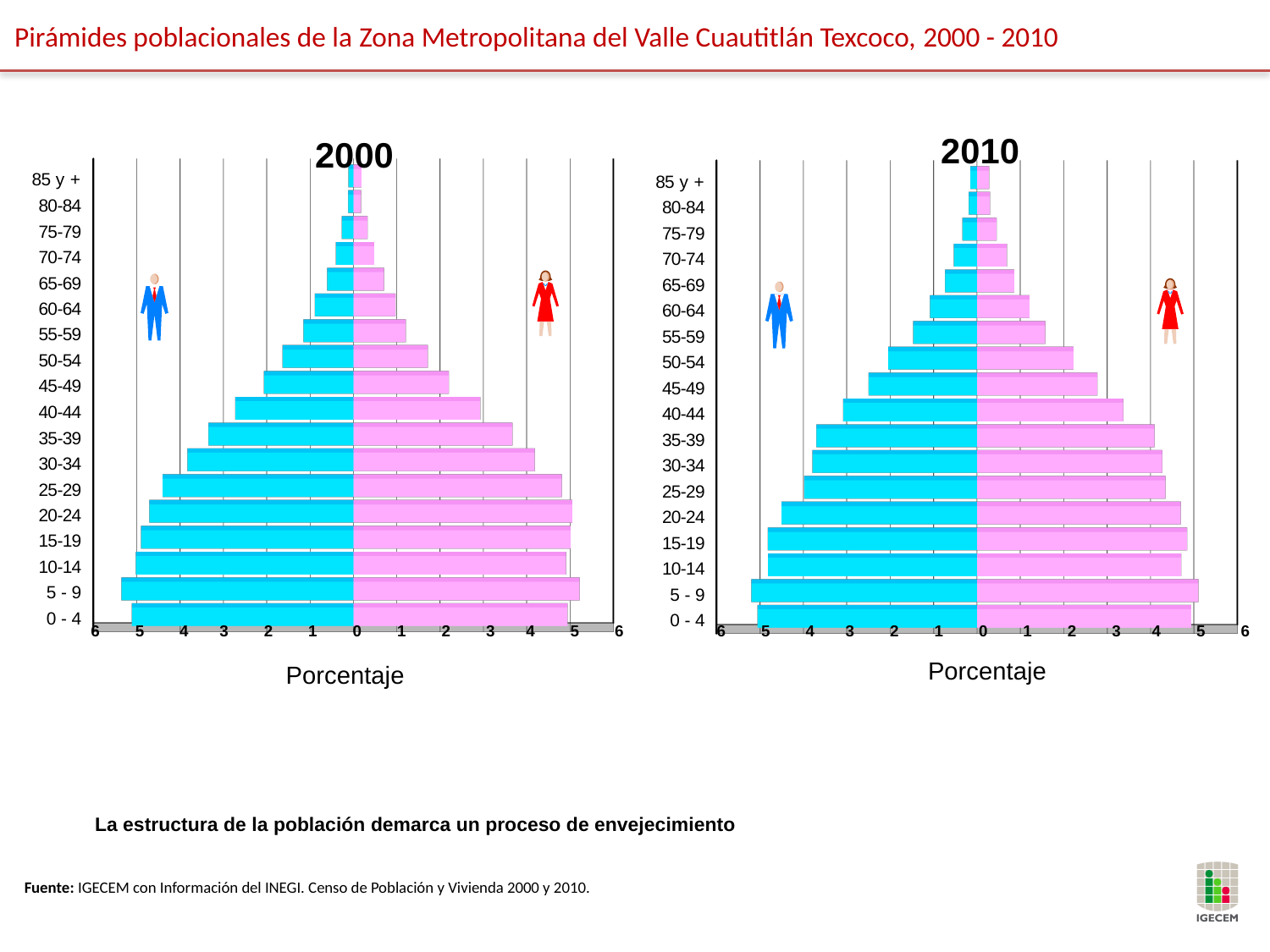
In the 2010 chart, is the female (pink) value for the 20-24 age group greater or less than 4? greater What kind of chart is shown for the year 2000? bar chart (population pyramid) In the 2010 chart, do the bars generally get longer or shorter as the age groups go from 0 - 4 up to 85 y +? shorter In the 2010 chart, which age group has the shortest bars? 85 y + In the 2010 chart, which female (pink) bar is longer: 45-49 or 65-69? 45-49 In the 2010 chart, is the male (blue) value for the 60-64 age group greater or less than 2? less What is the label on the horizontal axis of both charts? Porcentaje In the 2000 chart, which age group has the longest bars? 5 - 9 How many age groups are listed on the vertical axis of the 2010 chart? 18 In the 2000 chart, is the male (blue) value for the 40-44 age group greater or less than 3? less In the 2000 chart, which male (blue) bar is longer: 35-39 or 50-54? 35-39